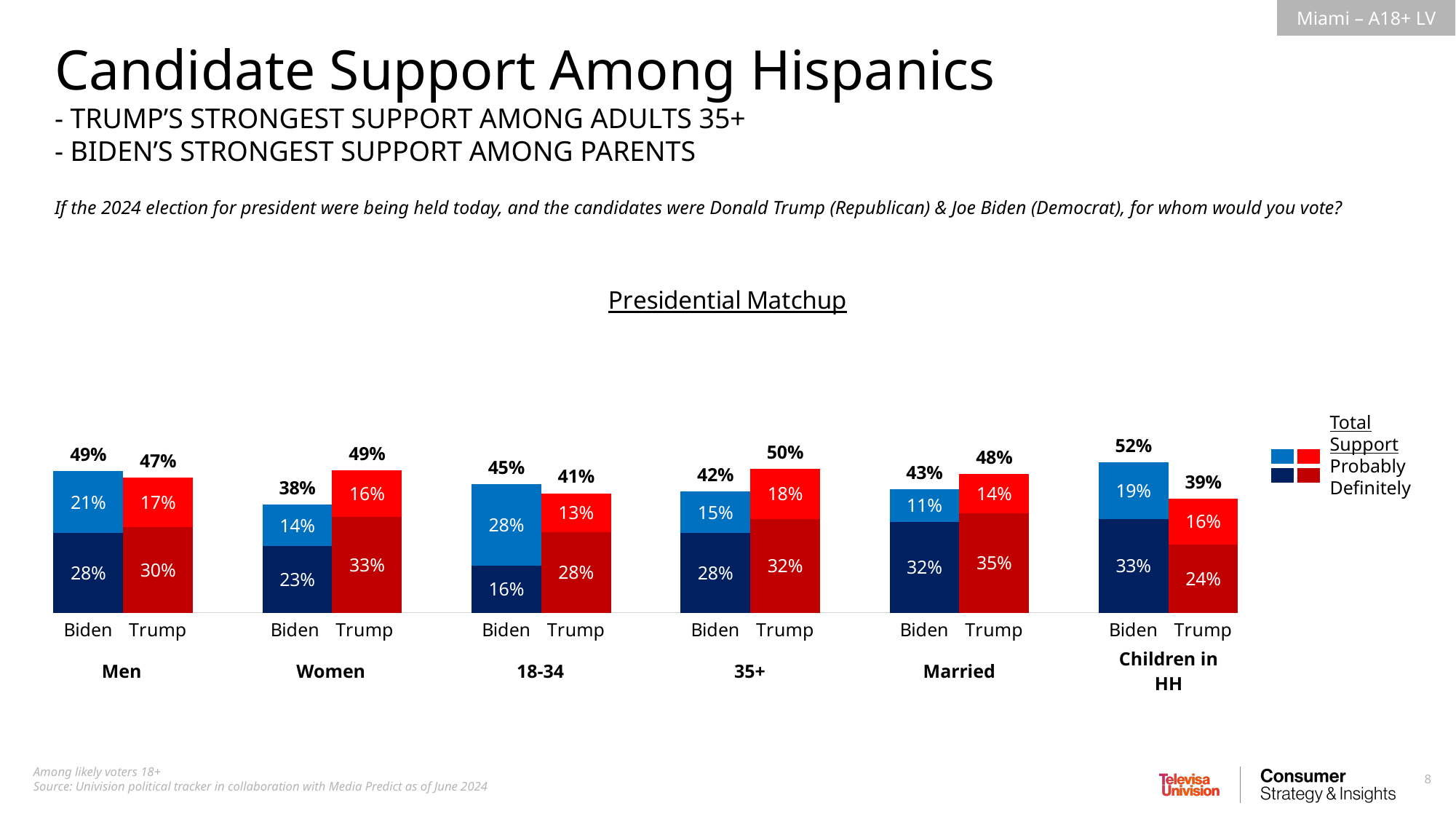
How many support levels does the legend list? 2 How many demographic groups are shown in the Presidential Matchup chart? 6 What kind of chart is the Presidential Matchup? Stacked bar chart What is the total support for Biden among Married voters, adding 'Definitely' and 'Probably'? 43% What is the total support for Biden among Men in the Presidential Matchup chart? 49% Which demographic group shows the highest total support for Biden? Children in HH What is the 'Probably' value for Biden among adults 18-34? 28% Which demographic group shows the lowest total support for Biden? Women In which demographic group does Trump have his highest total support? 35+ Among adults 35+, which candidate has the higher total support? Trump Among Children in HH, how many percentage points higher is Biden's total support than Trump's? 13 percentage points What share of Women say they would 'Definitely' vote for Trump? 33%